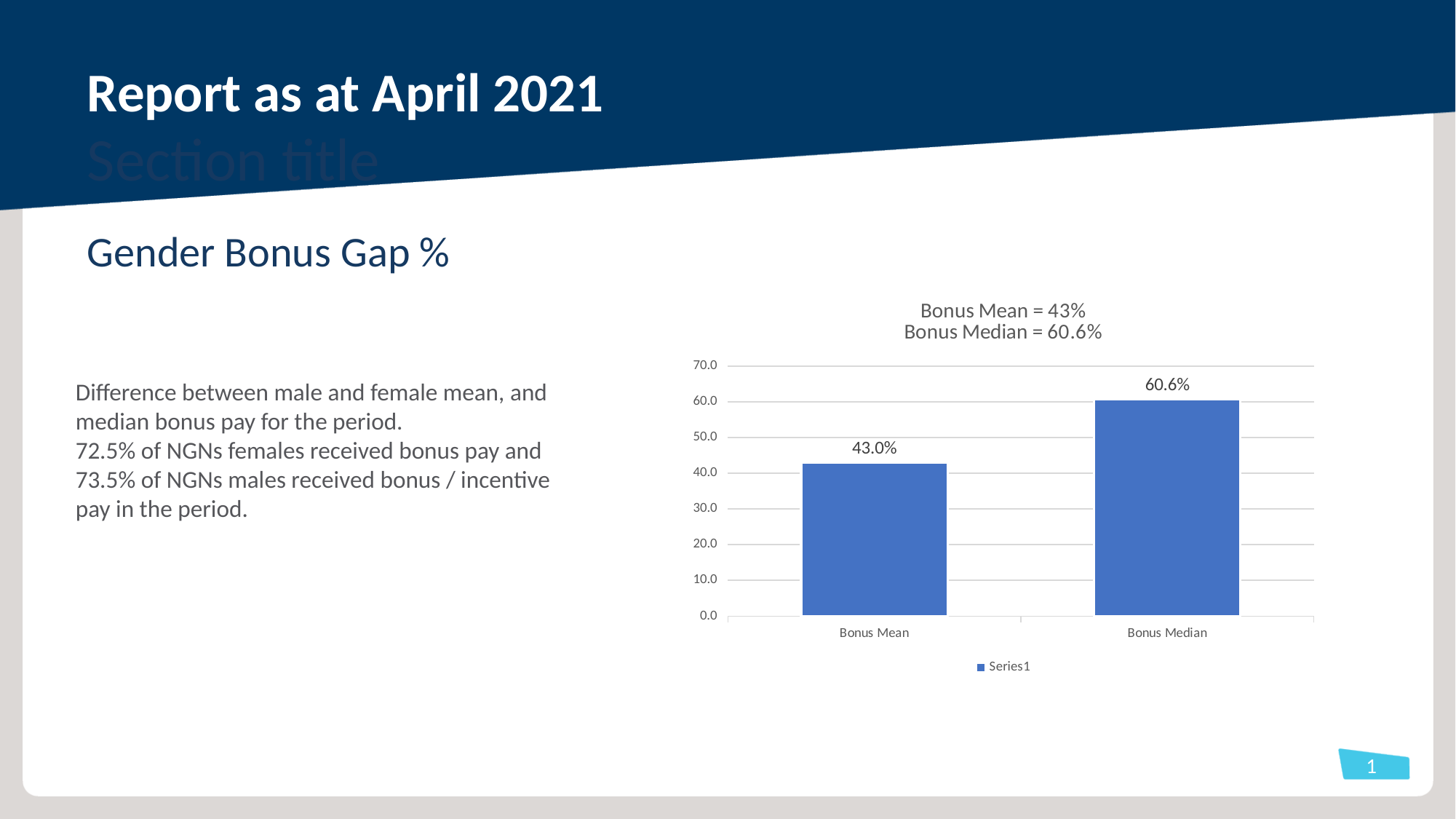
Is the value for Bonus Mean greater or less than 50.0? less What is the difference between the Bonus Median and Bonus Mean values? 17.6% What is the value for Bonus Median? 60.6% What is the value for Bonus Mean? 43.0% Which category has the lowest value? Bonus Mean How many categories are shown on the x axis? 2 Is the value for Bonus Median greater or less than 60.0? greater Which category has the highest value? Bonus Median What kind of chart is shown? Bar chart How many series does the legend list? 1 What is the title of the chart? Bonus Mean = 43% Bonus Median = 60.6% Which is larger, Bonus Mean or Bonus Median? Bonus Median